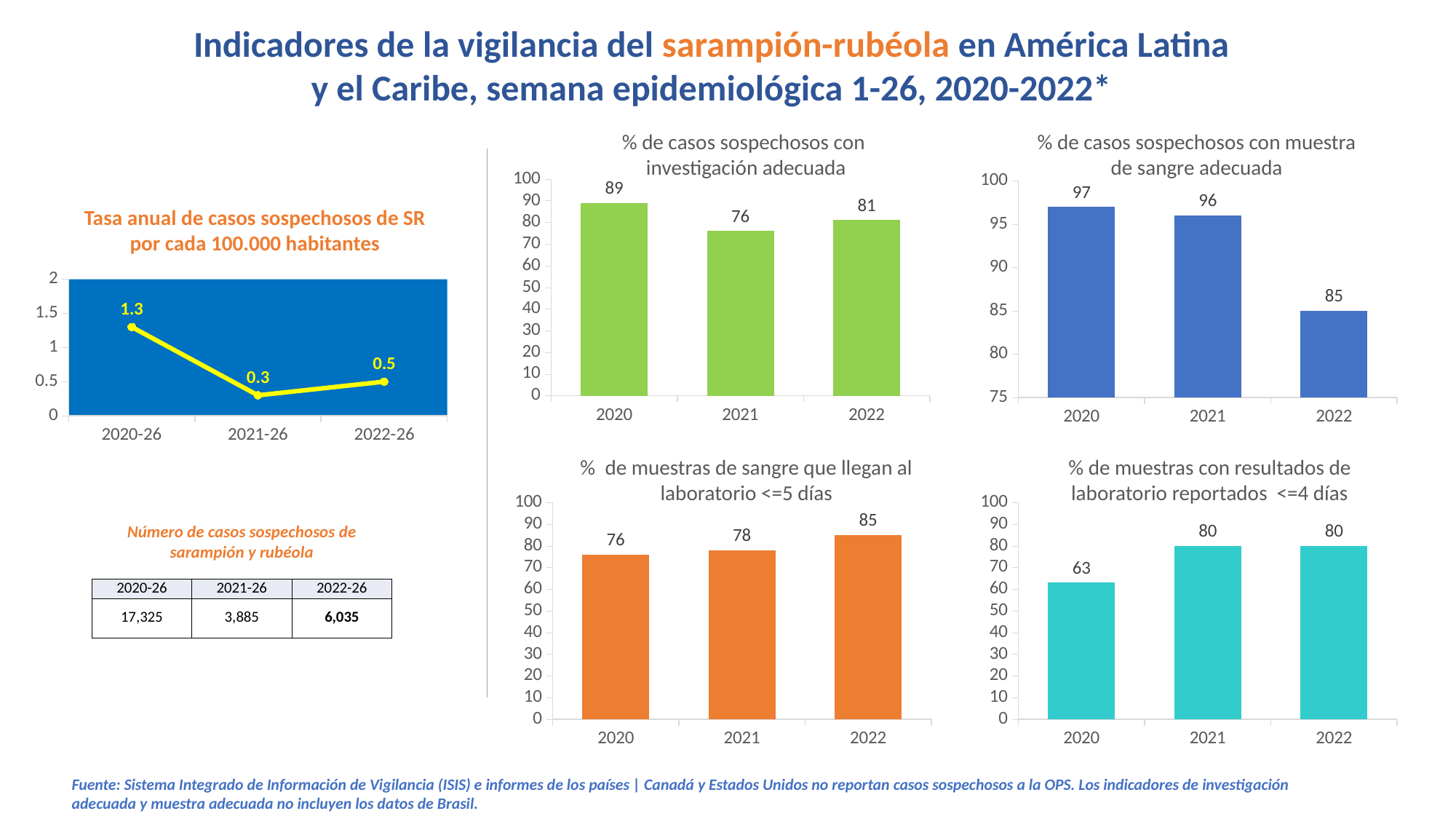
In the chart 'Tasa anual de casos sospechosos de SR por cada 100.000 habitantes', which period has the highest value? 2020-26 In the chart '% de muestras de sangre que llegan al laboratorio <=5 días', what is the value for 2022? 85 In the chart '% de casos sospechosos con investigación adecuada', what is the difference between 2020 and 2022? 8 In the chart '% de casos sospechosos con muestra de sangre adecuada', what is the value for 2020? 97 In the chart '% de muestras con resultados de laboratorio reportados <=4 días', which is larger, 2020 or 2021? 2021 In the chart '% de casos sospechosos con investigación adecuada', what is the value for 2021? 76 What kind of chart is 'Tasa anual de casos sospechosos de SR por cada 100.000 habitantes'? line chart How many years are shown on the x axis of the chart '% de casos sospechosos con investigación adecuada'? 3 In the chart '% de muestras con resultados de laboratorio reportados <=4 días', what is the difference between 2021 and 2020? 17 In the chart 'Tasa anual de casos sospechosos de SR por cada 100.000 habitantes', what is the value for 2021-26? 0.3 In the chart '% de muestras de sangre que llegan al laboratorio <=5 días', do the values rise or fall from 2020 to 2022? rise In the chart '% de casos sospechosos con muestra de sangre adecuada', which year has the lowest value? 2022